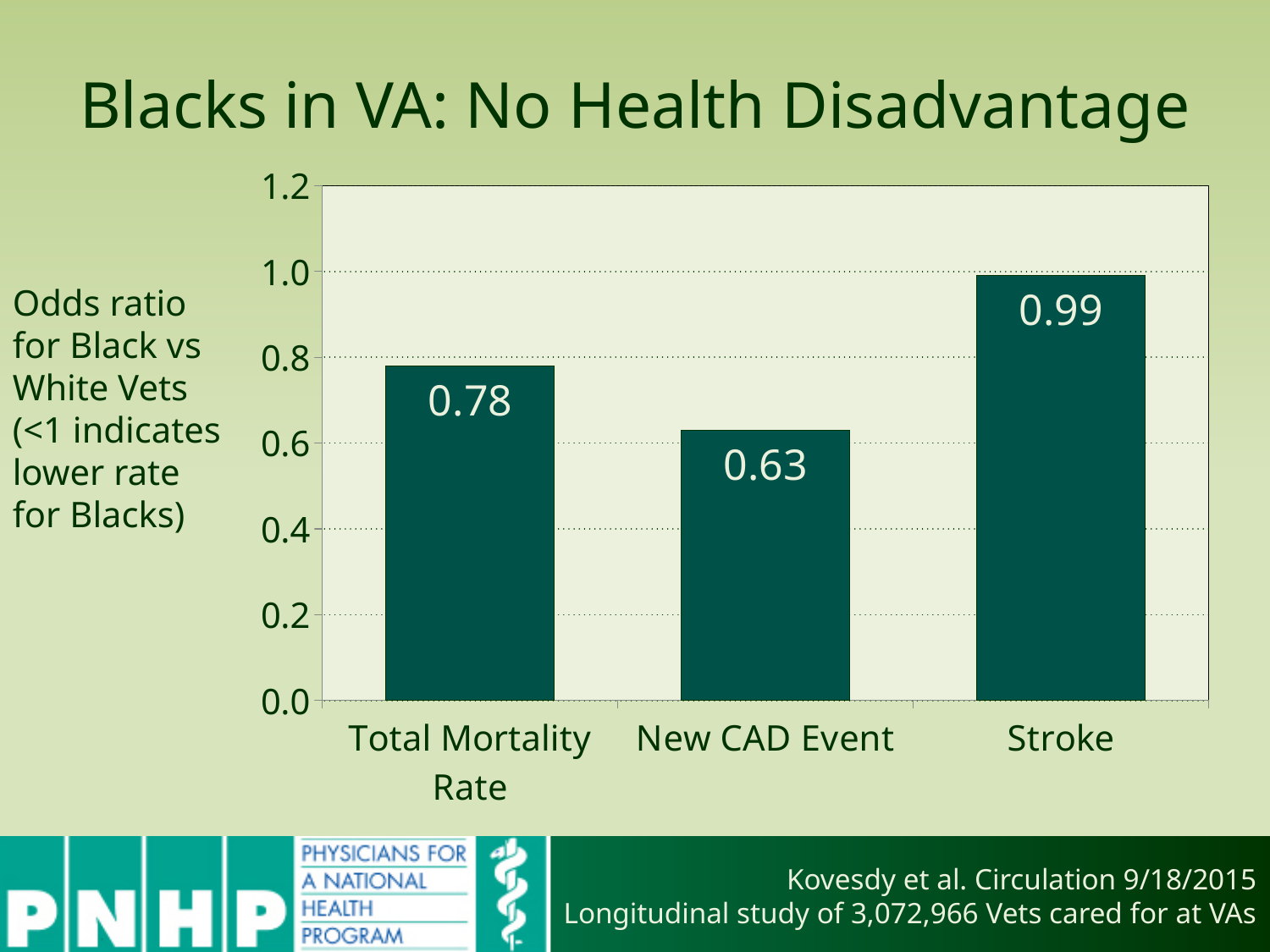
What is the odds ratio for New CAD Event? 0.63 What kind of chart is shown on the slide? bar chart Which category has the lowest odds ratio? New CAD Event What is the difference between the odds ratios for Stroke and New CAD Event? 0.36 Which is larger, the odds ratio for Total Mortality Rate or for Stroke? Stroke What is the difference between the odds ratios for Total Mortality Rate and New CAD Event? 0.15 How many categories are shown in the chart? 3 What is the odds ratio for Stroke? 0.99 What is the odds ratio for Total Mortality Rate? 0.78 Which category has the highest odds ratio? Stroke Is the odds ratio for New CAD Event greater or less than 0.8? less What is the title of the slide containing the chart? Blacks in VA: No Health Disadvantage